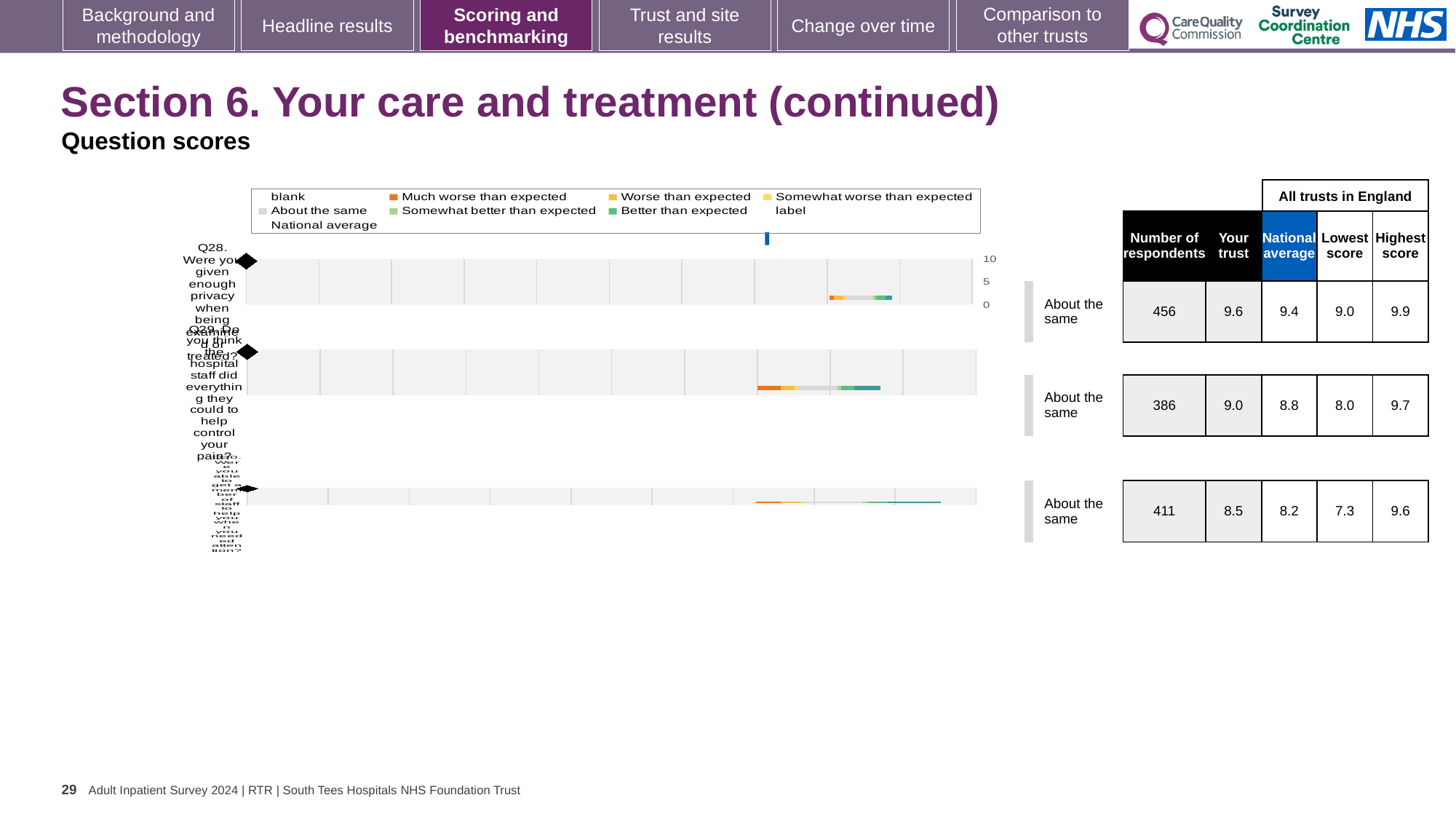
What benchmark category is shown for Q30? About the same Which question has the highest 'Your trust' score? Q28 Which question has the lowest 'Your trust' score? Q30 What is the difference between the 'Your trust' score and the national average for Q28? 0.2 What is the highest score among all trusts in England for Q28? 9.9 What is the lowest score among all trusts in England for Q30? 7.3 For Q29, which is larger: the 'Your trust' score or the national average? Your trust What kind of chart is used to show the question scores on this slide? bar chart How many questions (bars) are plotted on the slide? 3 How many respondents answered Q28? 456 What is the 'Your trust' score for Q28 (privacy when being examined or treated)? 9.6 What is the national average score for Q29 (staff did everything to help control your pain)? 8.8